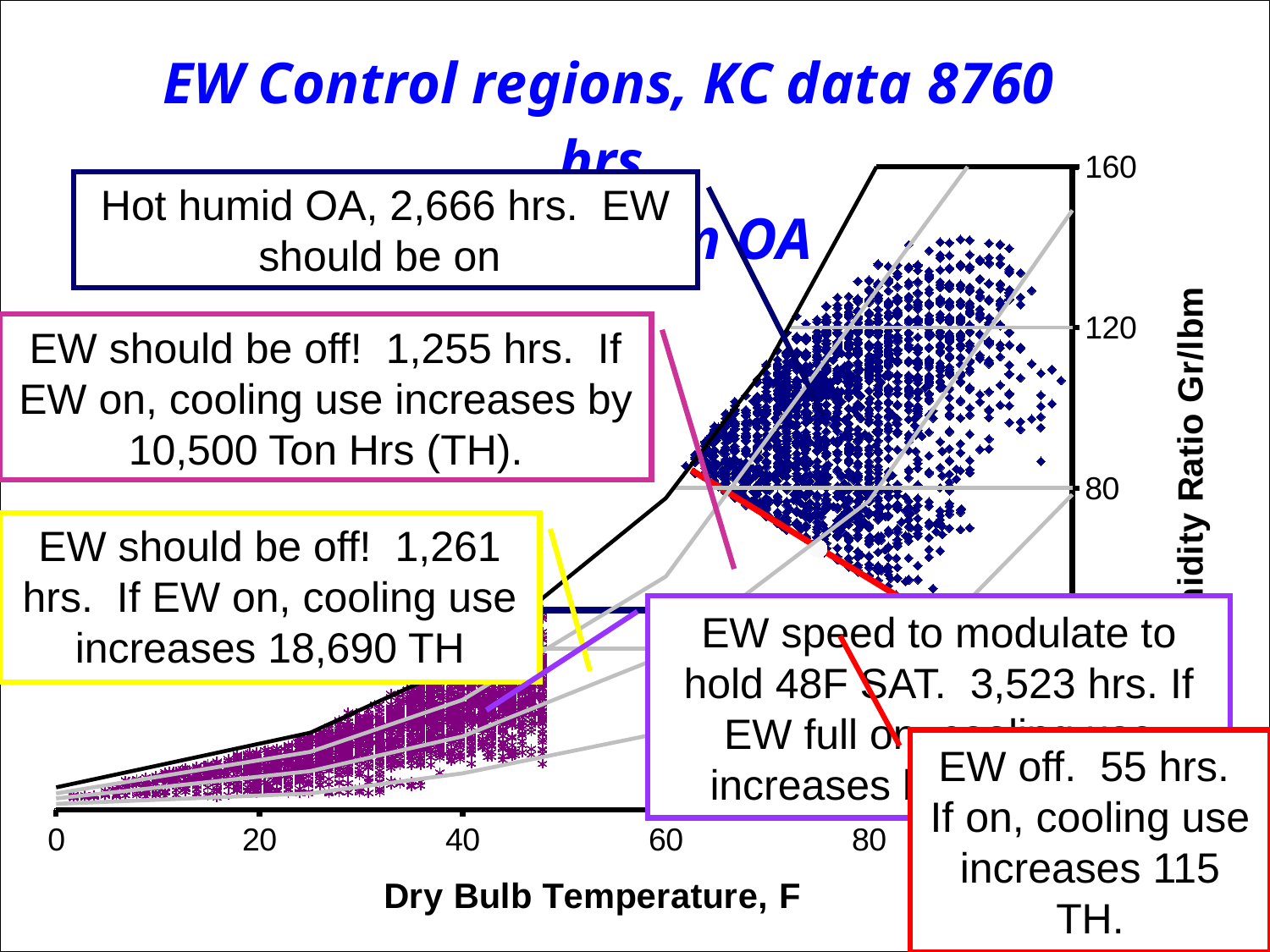
How many hours are in the 'EW off' region where cooling use would increase by 115 TH? 55 hrs What is the difference between the cooling use increases of 18,690 TH and 10,500 TH? 8,190 TH What is the difference in hours between the two 'EW should be off' regions (1,261 hrs and 1,255 hrs)? 6 hrs How many annotated control regions are labelled on the chart? 5 What kind of chart is shown on the slide? scatter chart What is the title of the chart? EW Control regions, KC data 8760 hrs How many hours are in the 'Hot humid OA' region where EW should be on? 2,666 hrs What is the label of the x axis? Dry Bulb Temperature, F By how much does cooling use increase if EW is on in the 1,261-hour 'EW should be off' region? 18,690 TH Which annotated control region has the most hours? EW speed to modulate to hold 48F SAT (3,523 hrs) Which annotated control region has the fewest hours? EW off (55 hrs) How many hours are in the region where EW speed modulates to hold 48F SAT? 3,523 hrs